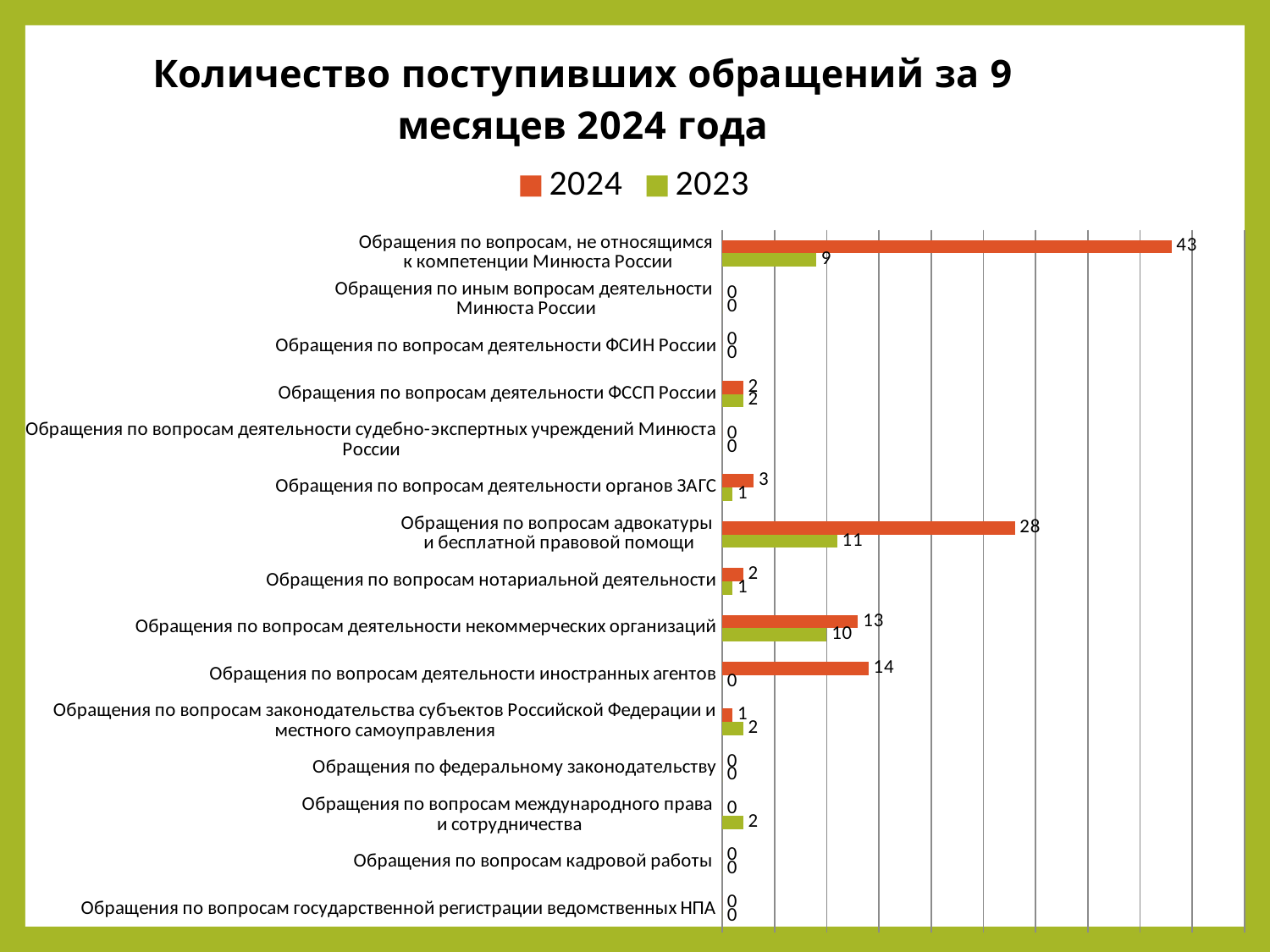
What is the 2023 value for "Обращения по вопросам адвокатуры и бесплатной правовой помощи"? 11 What is the difference between the 2024 and 2023 values for "Обращения по вопросам адвокатуры и бесплатной правовой помощи"? 17 What is the difference between the 2024 and 2023 values for "Обращения по вопросам деятельности некоммерческих организаций"? 3 What is the 2024 value for "Обращения по вопросам, не относящимся к компетенции Минюста России"? 43 Which category has the highest 2023 value? Обращения по вопросам адвокатуры и бесплатной правовой помощи What is the 2024 value for "Обращения по вопросам деятельности иностранных агентов"? 14 What is the 2023 value for "Обращения по вопросам международного права и сотрудничества"? 2 How many series does the legend list? 2 For "Обращения по вопросам законодательства субъектов Российской Федерации и местного самоуправления", which year has the larger value, 2024 or 2023? 2023 How many categories are shown on the chart? 15 What kind of chart is shown on the slide? Bar chart Which category has the highest 2024 value? Обращения по вопросам, не относящимся к компетенции Минюста России